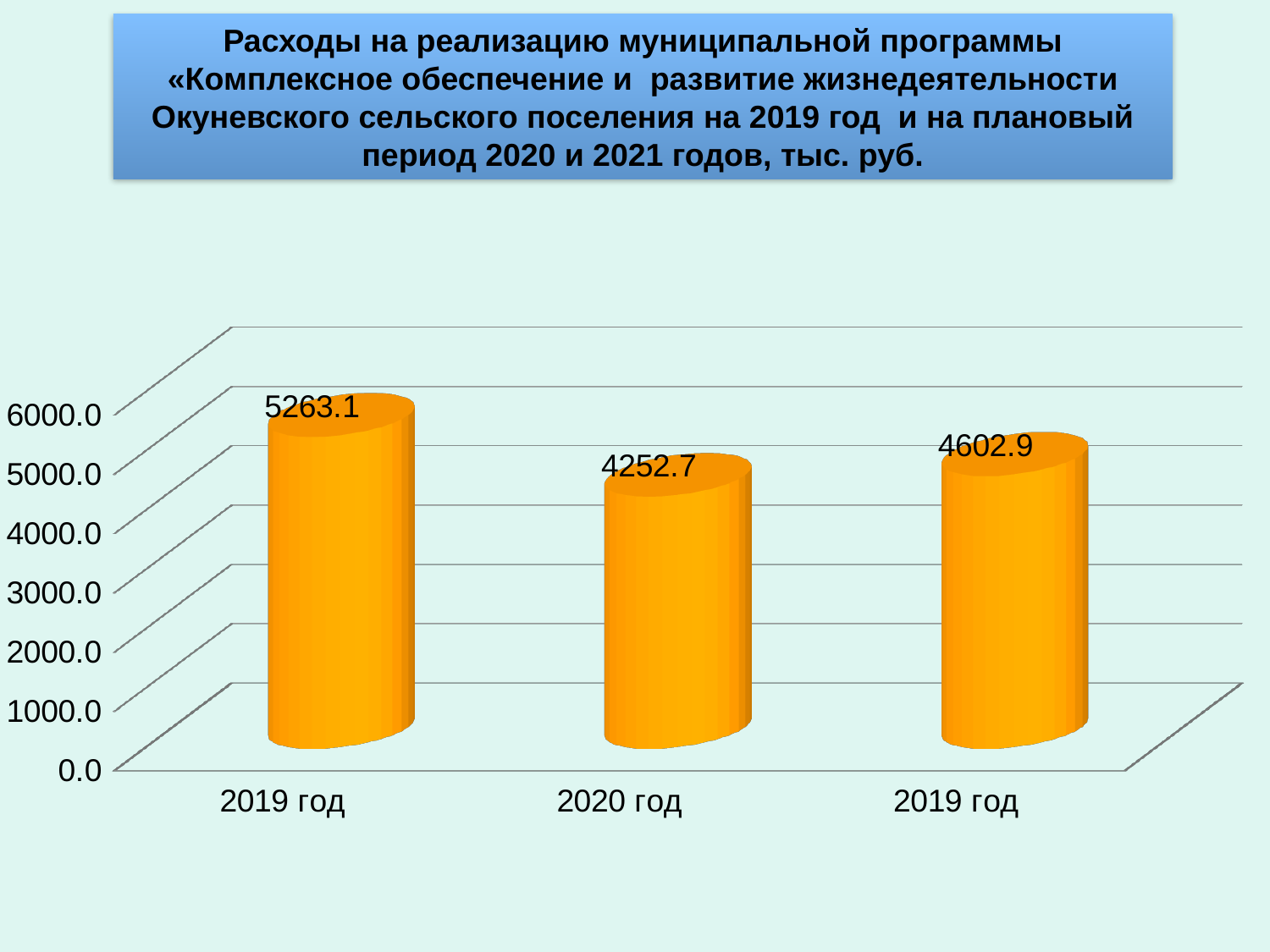
What is the value of the first (leftmost) bar, labelled 2019 год? 5263.1 How many bars are shown in the chart? 3 Which bar has the highest value? The first bar (2019 год), 5263.1 What unit of measurement is stated in the chart title? тыс. руб. What is the difference between the first bar (5263.1) and the 2020 год bar? 1010.4 What is the value of the third (rightmost) bar? 4602.9 What is the value for 2020 год? 4252.7 What kind of chart is shown on the slide? Bar chart Which category has the lowest value? 2020 год Is the value for 2020 год greater or less than 5000.0? less What is the difference between the rightmost bar and the 2020 год bar? 350.2 Which is larger, the value for 2020 год or the value of the rightmost bar? The rightmost bar (4602.9)